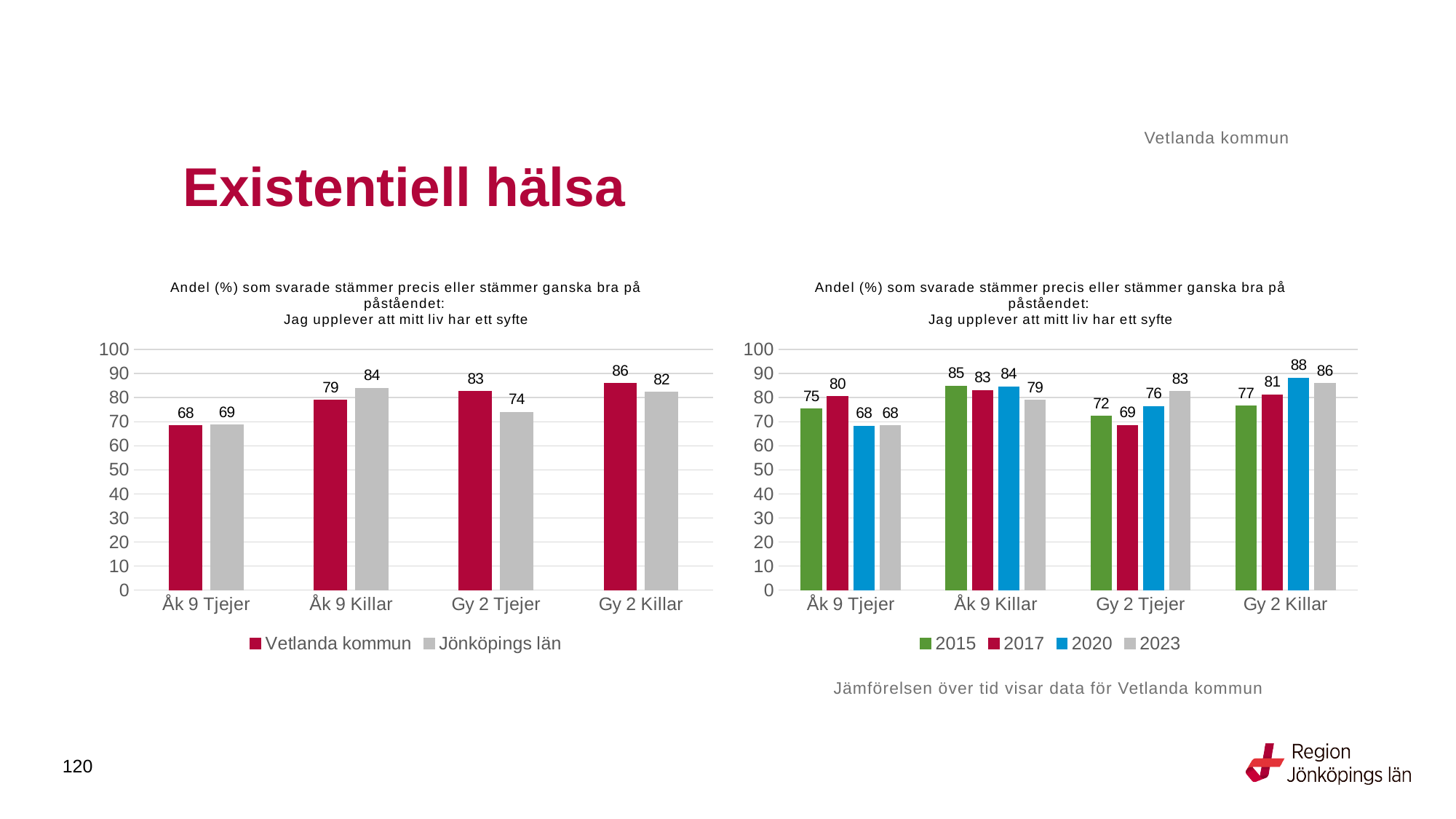
In the right chart, what is the difference between the 2023 and 2015 values for Gy 2 Tjejer? 11 What kind of chart is the right chart? Bar chart In the left chart, what is the value for Jönköpings län for Åk 9 Killar? 84 How many series does the legend of the right chart list? 4 In the right chart, what is the value for 2015 for Åk 9 Tjejer? 75 In the left chart, which category has the highest value for Vetlanda kommun? Gy 2 Killar In the right chart, which category has the lowest value for 2017? Gy 2 Tjejer In the left chart, which is larger for Åk 9 Killar: Vetlanda kommun or Jönköpings län? Jönköpings län In the left chart, what is the difference between Vetlanda kommun and Jönköpings län for Gy 2 Tjejer? 9 How many categories are shown on the x axis of the left chart? 4 In the left chart, what is the value for Vetlanda kommun for Gy 2 Tjejer? 83 In the right chart, what is the value for 2020 for Gy 2 Killar? 88